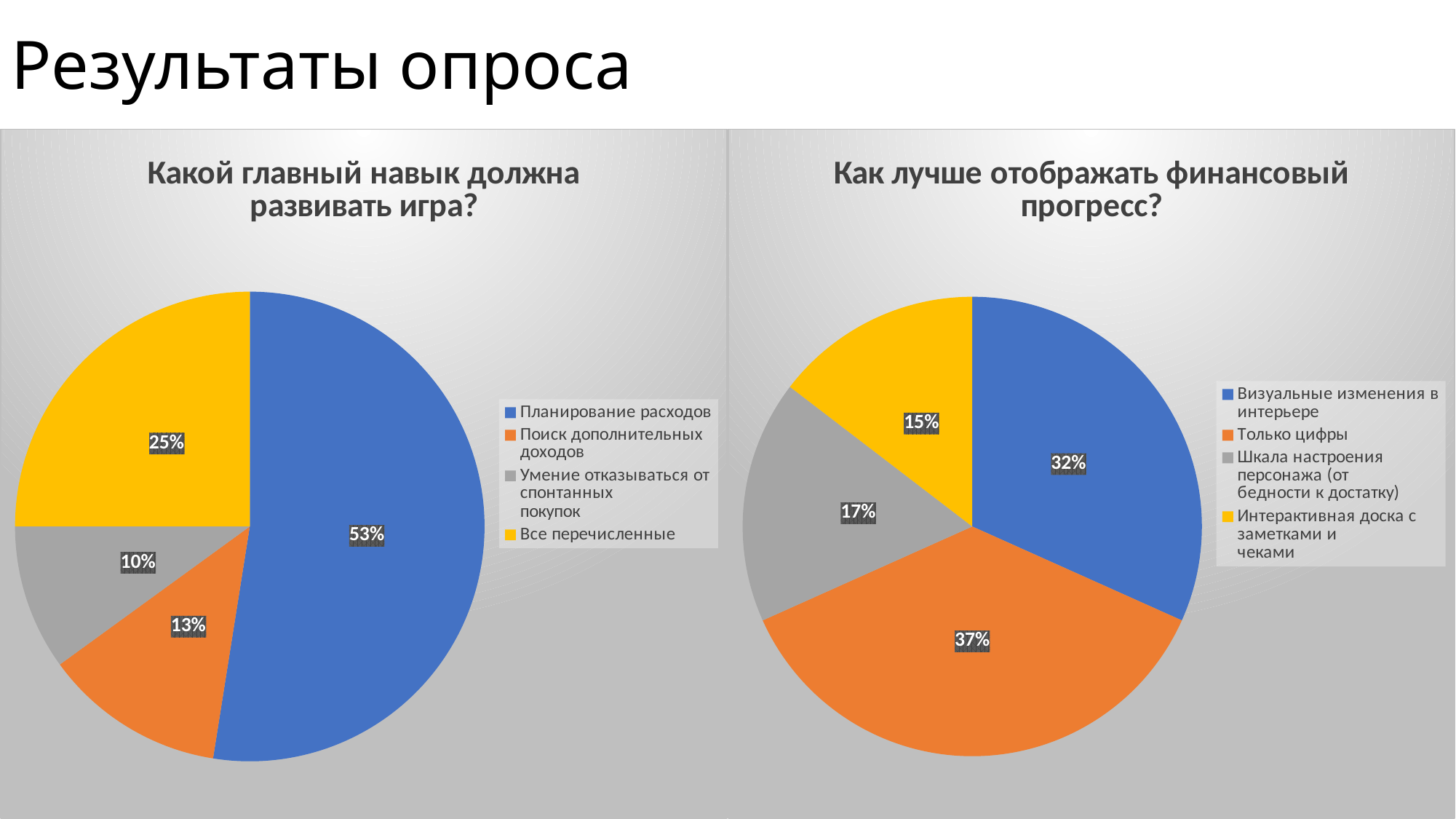
In the chart titled "Как лучше отображать финансовый прогресс?", which is larger: "Визуальные изменения в интерьере" or "Шкала настроения персонажа (от бедности к достатку)"? Визуальные изменения в интерьере In the chart titled "Как лучше отображать финансовый прогресс?", what share is labelled for "Только цифры"? 37% In the chart titled "Как лучше отображать финансовый прогресс?", what share is labelled for "Интерактивная доска с заметками и чеками"? 15% In the chart titled "Какой главный навык должна развивать игра?", how many slices does the pie have? 4 In the chart titled "Как лучше отображать финансовый прогресс?", what is the difference between the shares for "Только цифры" and "Визуальные изменения в интерьере"? 5% In the chart titled "Какой главный навык должна развивать игра?", what colour is the slice for "Поиск дополнительных доходов"? Orange In the chart titled "Какой главный навык должна развивать игра?", what share is labelled for "Планирование расходов"? 53% In the chart titled "Какой главный навык должна развивать игра?", which category has the smallest slice? Умение отказываться от спонтанных покупок In the chart titled "Как лучше отображать финансовый прогресс?", which category has the largest slice? Только цифры In the chart titled "Какой главный навык должна развивать игра?", what is the difference between the shares for "Планирование расходов" and "Поиск дополнительных доходов"? 40% What type of chart is used for "Как лучше отображать финансовый прогресс?"? Pie chart In the chart titled "Какой главный навык должна развивать игра?", what share is labelled for "Все перечисленные"? 25%